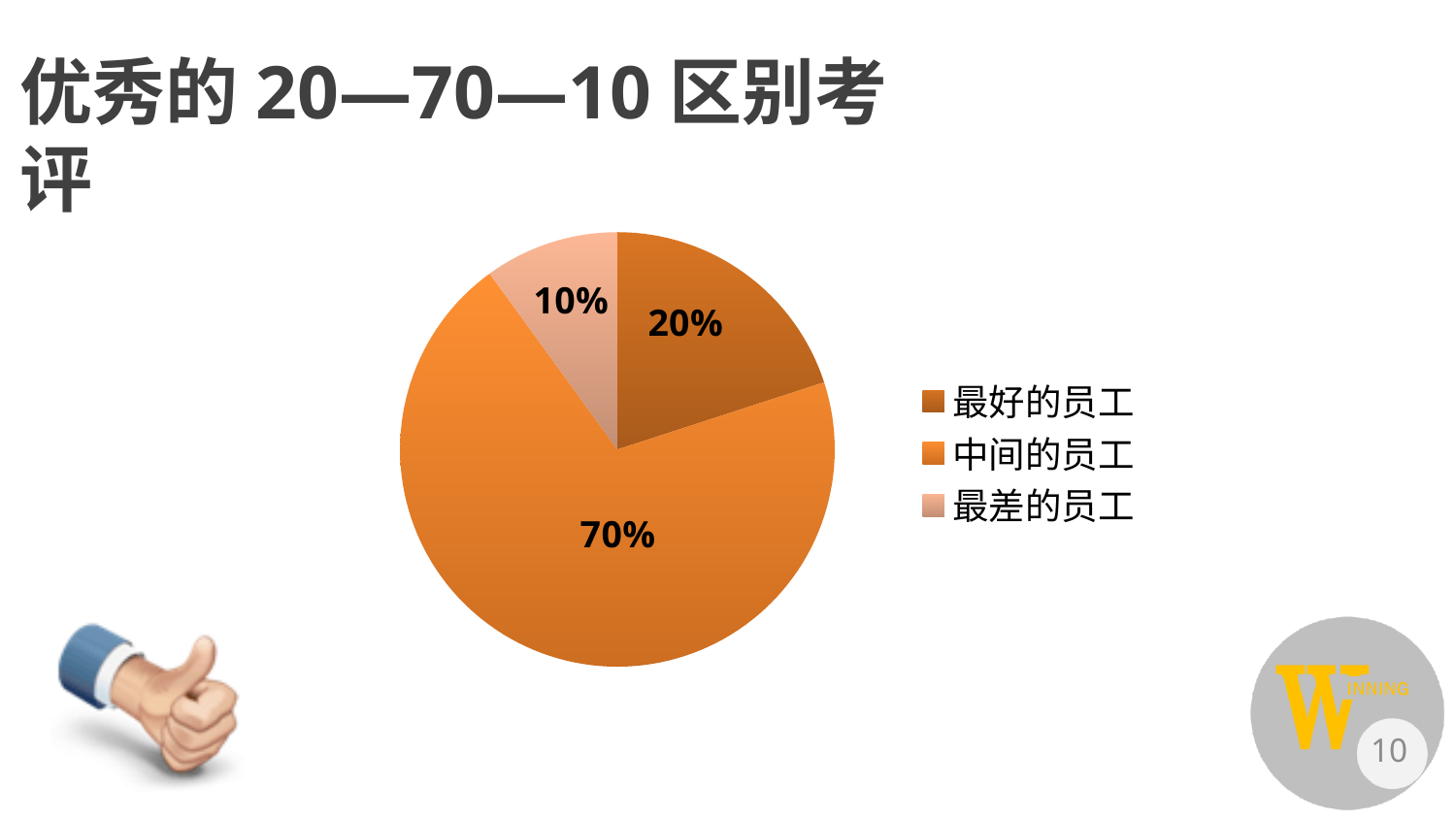
Which category has the smallest slice of the pie? 最差的员工 How many entries does the legend list? 3 Which is larger, the share of 最好的员工 or the share of 最差的员工? 最好的员工 What share of the pie does 最好的员工 represent? 20% Which legend entry is shown with the lightest colour? 最差的员工 What share of the pie does 最差的员工 represent? 10% What is the difference between the shares of 最好的员工 and 最差的员工? 10% What is the difference between the shares of 中间的员工 and 最好的员工? 50% Which category has the largest slice of the pie? 中间的员工 What share of the pie does 中间的员工 represent? 70% What kind of chart is shown on the slide? pie chart How many slices does the pie chart have? 3